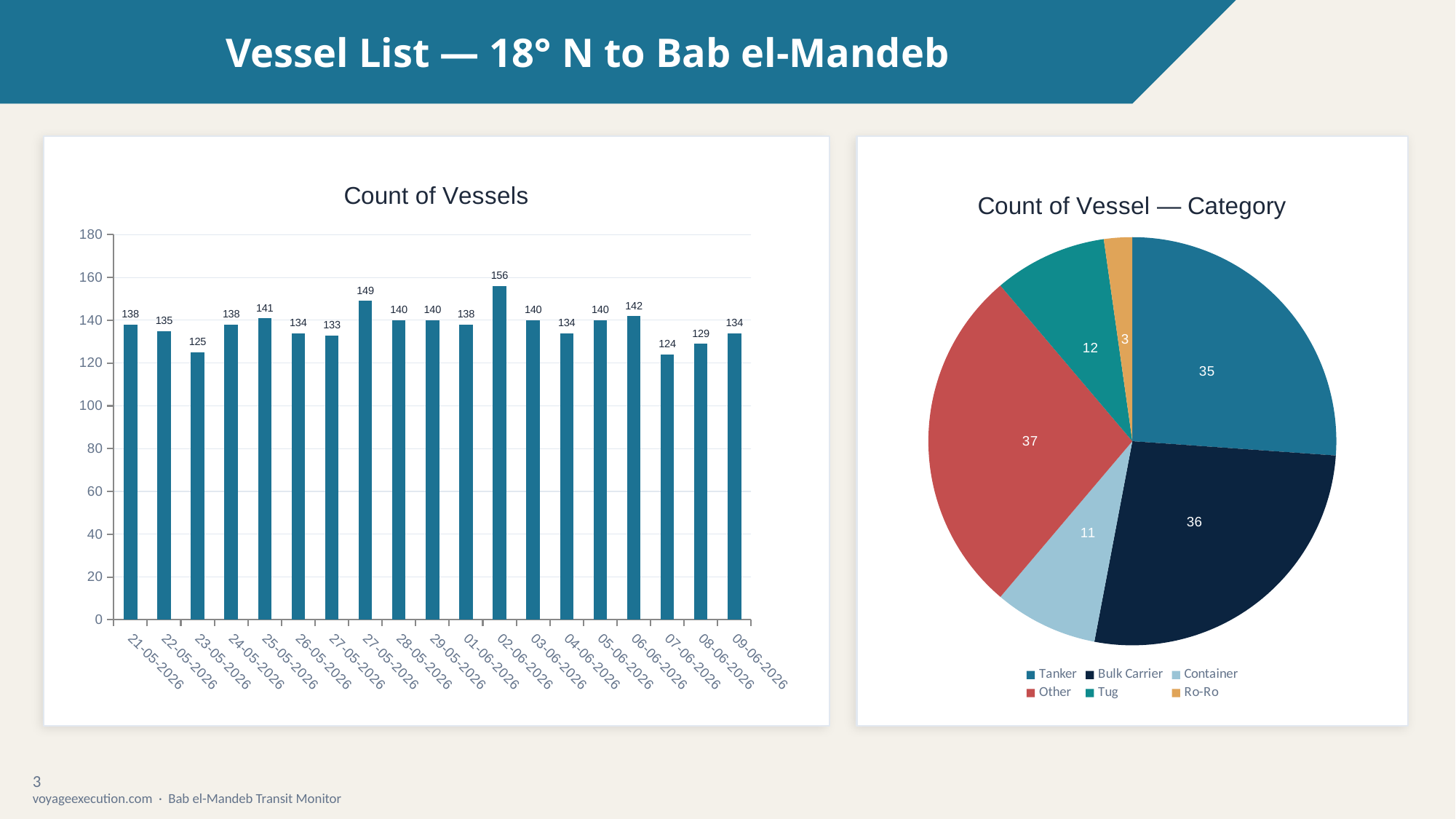
In the 'Count of Vessels' bar chart, which date has the highest count? 02-06-2026 How many categories does the legend of the 'Count of Vessel — Category' pie chart list? 6 In the 'Count of Vessels' bar chart, what is the difference between the values for 02-06-2026 and 07-06-2026? 32 In the 'Count of Vessel — Category' pie chart, which category has the largest slice? Other In the 'Count of Vessels' bar chart, which is larger: the value for 25-05-2026 or the value for 08-06-2026? 25-05-2026 In the 'Count of Vessel — Category' pie chart, what is the value for Bulk Carrier? 36 In the 'Count of Vessels' bar chart, which date has the lowest count? 07-06-2026 In the 'Count of Vessels' bar chart, what is the value for 02-06-2026? 156 In the 'Count of Vessels' bar chart, how many bars are plotted? 19 In the 'Count of Vessel — Category' pie chart, which category has the smallest slice? Ro-Ro What kind of chart is the 'Count of Vessels' chart? Bar chart In the 'Count of Vessels' bar chart, what is the value for 23-05-2026? 125